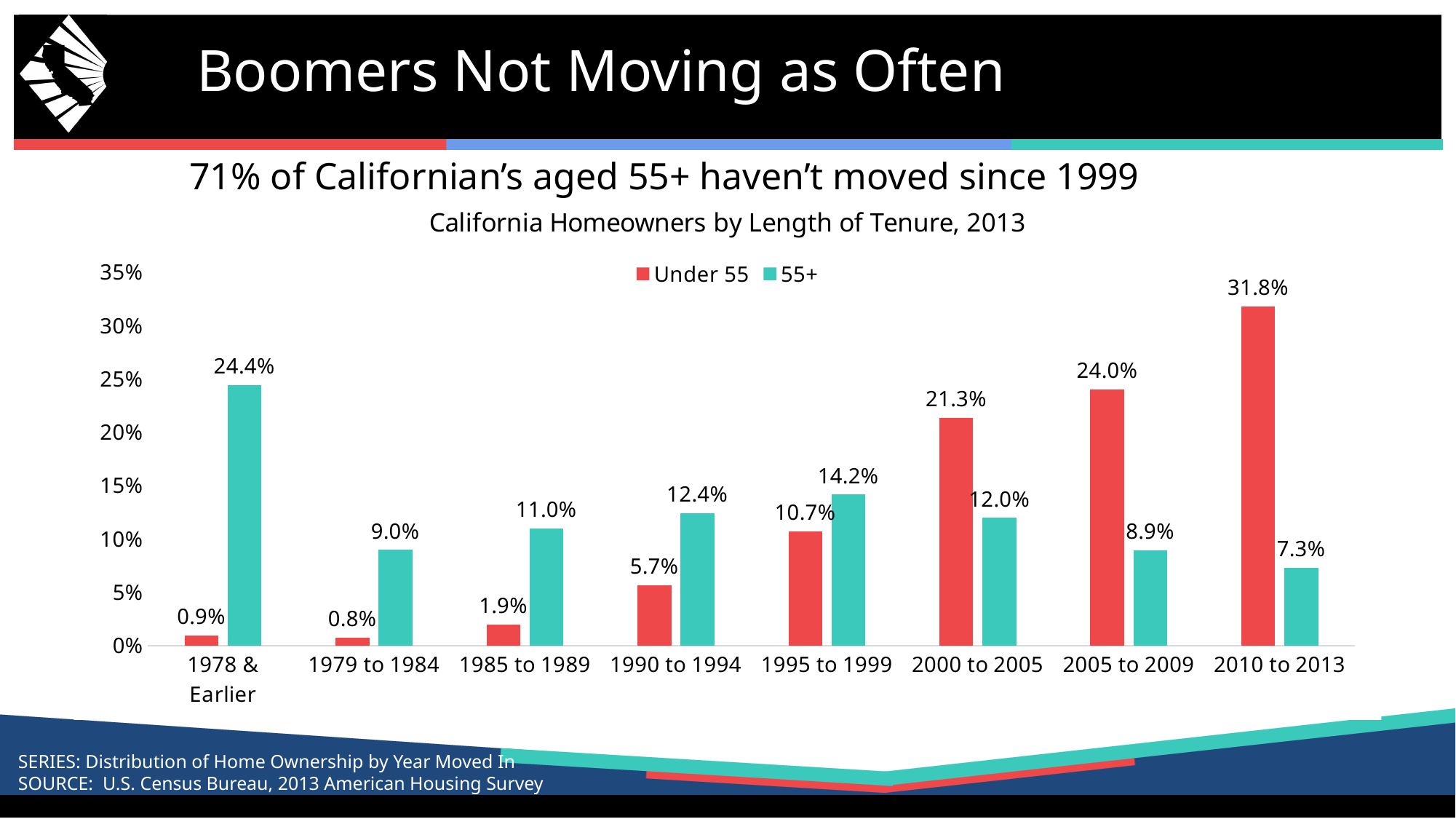
How many series does the legend list? 2 What is the title of the chart? California Homeowners by Length of Tenure, 2013 What is the difference between the Under 55 and 55+ values in the 2010 to 2013 category? 24.5% How many tenure categories are shown on the x axis? 8 What is the value for Under 55 in the 2010 to 2013 category? 31.8% What is the value for 55+ in the 1978 & Earlier category? 24.4% Which category has the lowest value for the Under 55 series? 1979 to 1984 Which category has the highest value for the Under 55 series? 2010 to 2013 Which category has the lowest value for the 55+ series? 2010 to 2013 What is the value for 55+ in the 1995 to 1999 category? 14.2% What kind of chart is shown on the slide? Bar chart Which is larger in the 2000 to 2005 category, Under 55 or 55+? Under 55